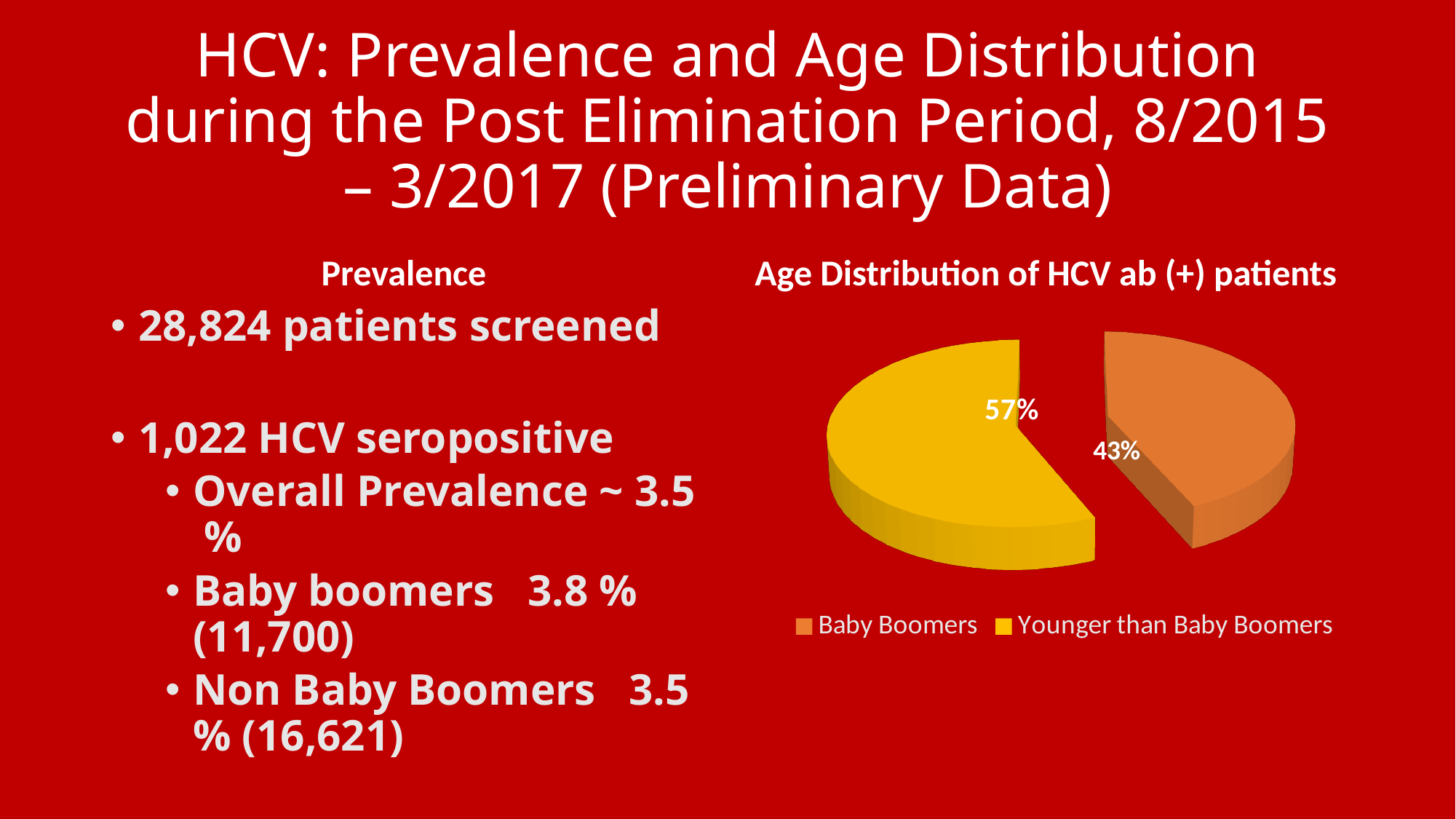
What percentage of the pie is Baby Boomers? 43% What percentage of the pie is Younger than Baby Boomers? 57% Is the Baby Boomers share of the pie greater or less than 50%? less How many slices does the pie chart have? 2 How many entries does the legend list? 2 Which slice of the pie is the largest? Younger than Baby Boomers Which is larger: the Baby Boomers slice or the Younger than Baby Boomers slice? Younger than Baby Boomers Which slice of the pie is the smallest? Baby Boomers What is the difference in percentage points between the Younger than Baby Boomers slice and the Baby Boomers slice? 14 What type of chart is shown on the slide? Pie chart What colour is the Baby Boomers slice? Orange What is the title of the chart? Age Distribution of HCV ab (+) patients